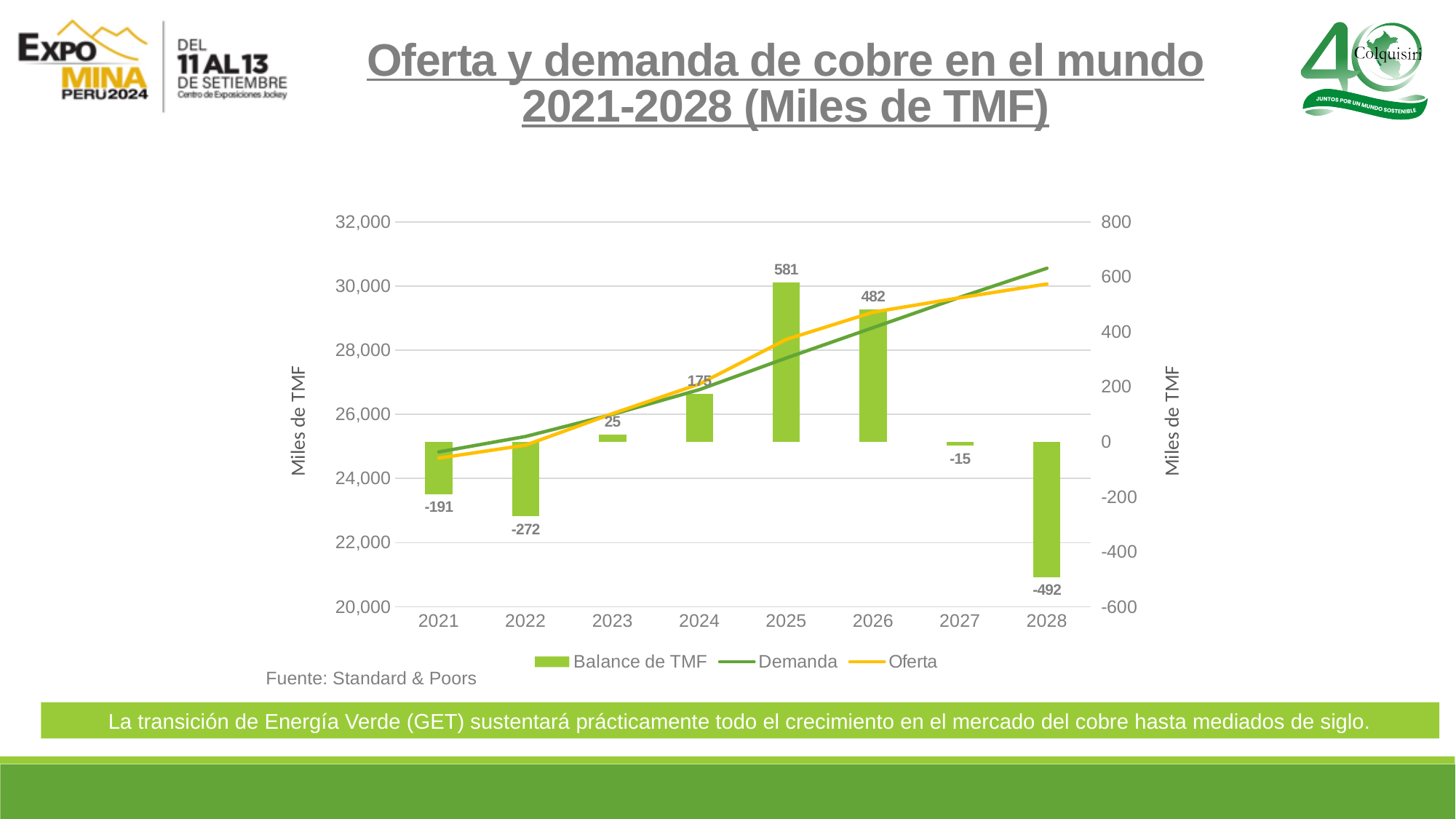
Which year has the highest Balance de TMF? 2025 How many years are shown on the x axis? 8 What is the value of Balance de TMF for 2022? -272 Which year has the lowest Balance de TMF? 2028 What is the value of Balance de TMF for 2025? 581 How many series does the legend list? 3 Is the Demanda value for 2028 greater or less than 30,000? greater What is the difference between the Balance de TMF values for 2025 and 2026? 99 What kind of chart is this? Combined bar and line chart Which year has a larger Balance de TMF, 2024 or 2026? 2026 What is the value of Balance de TMF for 2028? -492 Does the Demanda line rise or fall from 2021 to 2028? Rises